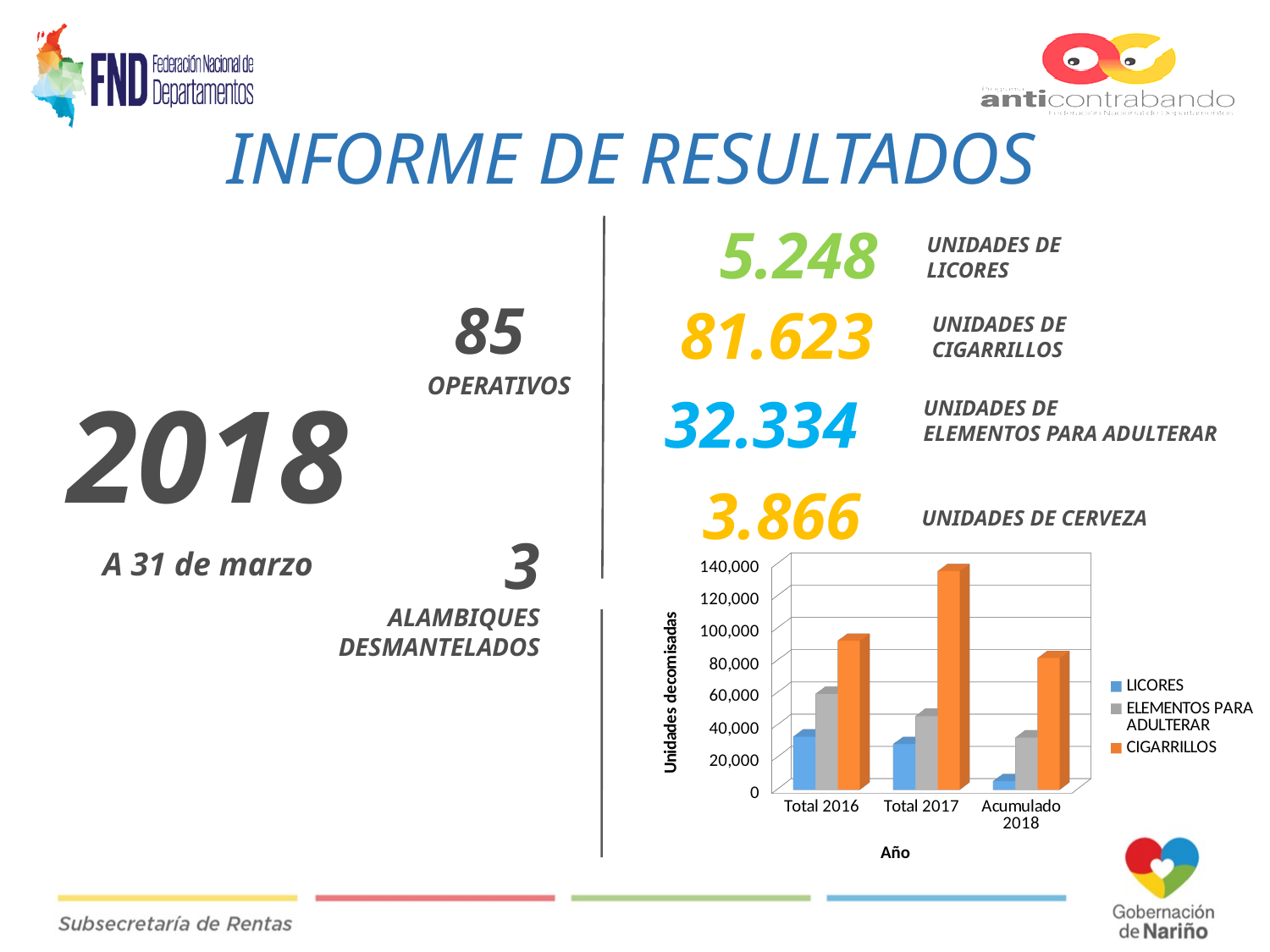
What kind of chart is shown on the slide? bar chart How many categories are shown on the x axis of the chart? 3 Is the value for CIGARRILLOS in Total 2017 greater or less than 120,000? greater Which category has the lowest value for LICORES? Acumulado 2018 Which is larger in Total 2016: LICORES or ELEMENTOS PARA ADULTERAR? ELEMENTOS PARA ADULTERAR Do the values for LICORES rise or fall from Total 2016 to Acumulado 2018? fall How many series does the chart legend list? 3 Which series is shown in orange in the chart? CIGARRILLOS Is the value for ELEMENTOS PARA ADULTERAR in Total 2016 greater or less than 40,000? greater Which category has the highest value for CIGARRILLOS? Total 2017 Is the value for LICORES in Acumulado 2018 greater or less than 20,000? less What is the title of the vertical axis of the chart? Unidades decomisadas